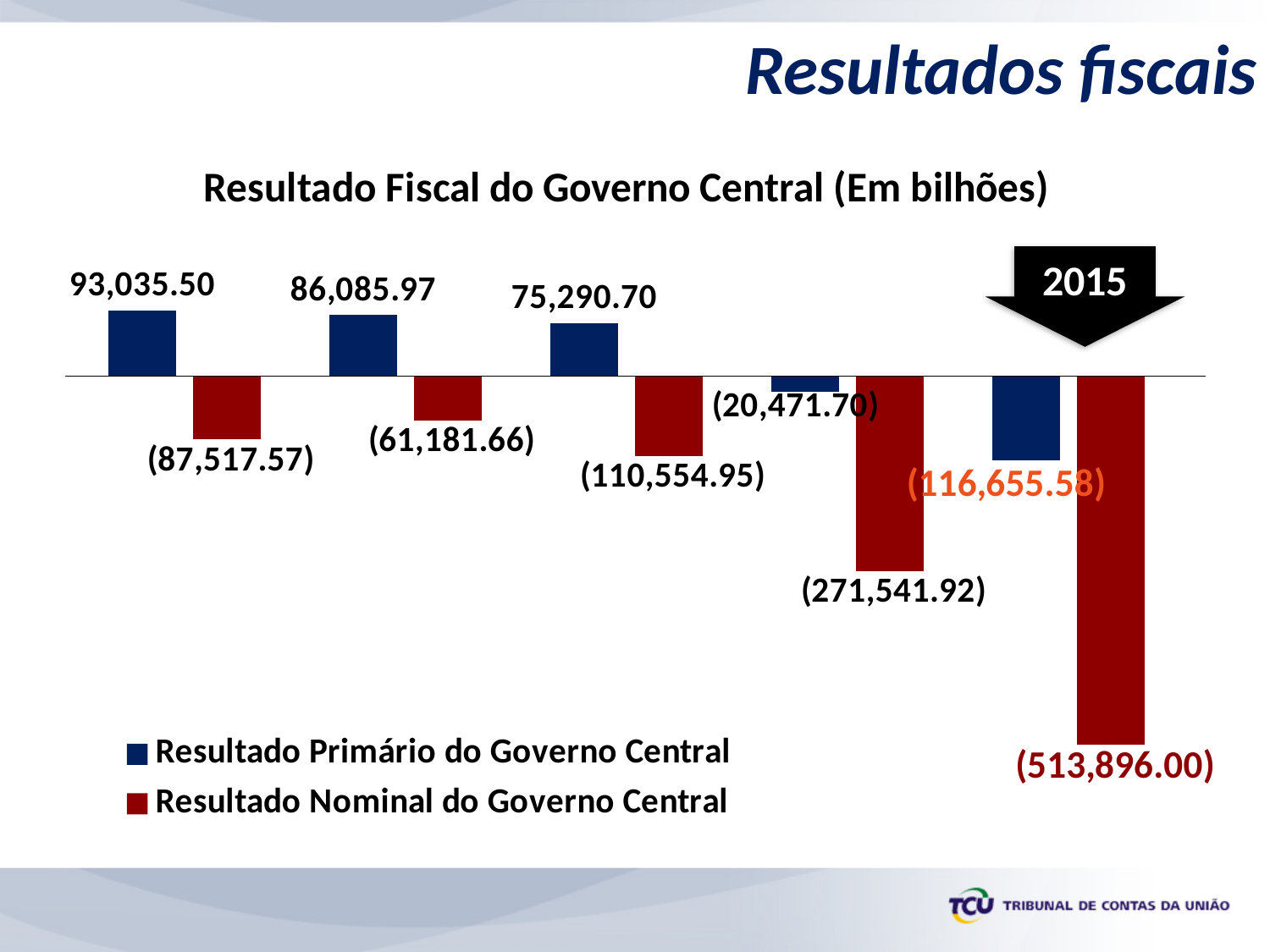
Do the Resultado Primário do Governo Central values rise or fall from left to right across the chart? fall What are the two series named in the legend? Resultado Primário do Governo Central; Resultado Nominal do Governo Central What is the value of Resultado Primário do Governo Central for 2015 (the rightmost group)? (116,655.58) What is the highest value of Resultado Primário do Governo Central shown? 93,035.50 What kind of chart is shown on the slide? bar chart What is the value of Resultado Nominal do Governo Central for 2015 (the rightmost group)? (513,896.00) What is the value of Resultado Nominal do Governo Central in the fourth group of bars from the left? (271,541.92) How many groups of bars (periods) are plotted in the chart? 5 What is the lowest (most negative) value of Resultado Nominal do Governo Central shown? (513,896.00) What is the title of the chart? Resultado Fiscal do Governo Central (Em bilhões) How many series does the legend list? 2 What is the value of Resultado Primário do Governo Central in the leftmost group of bars? 93,035.50